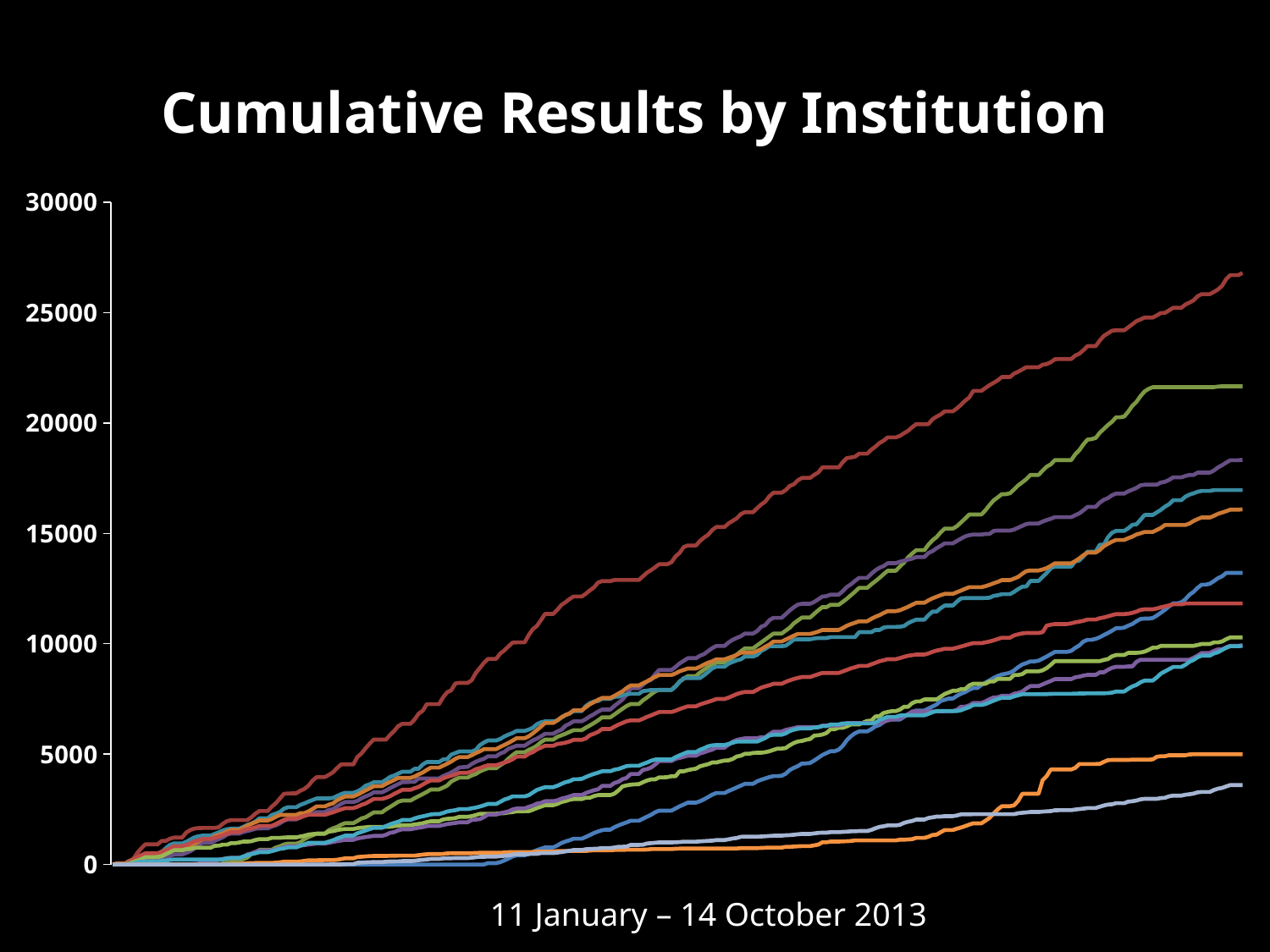
Does any line reach the 30000 mark on the y axis? No Is the final value of the second-highest line greater or less than 20000? greater Is the final value of the highest line greater or less than 25000? greater Do the lines generally rise or fall from left to right along the x axis? rise What is the title of the chart? Cumulative Results by Institution What kind of chart is shown on the slide? line chart What date range is shown beneath the chart? 11 January – 14 October 2013